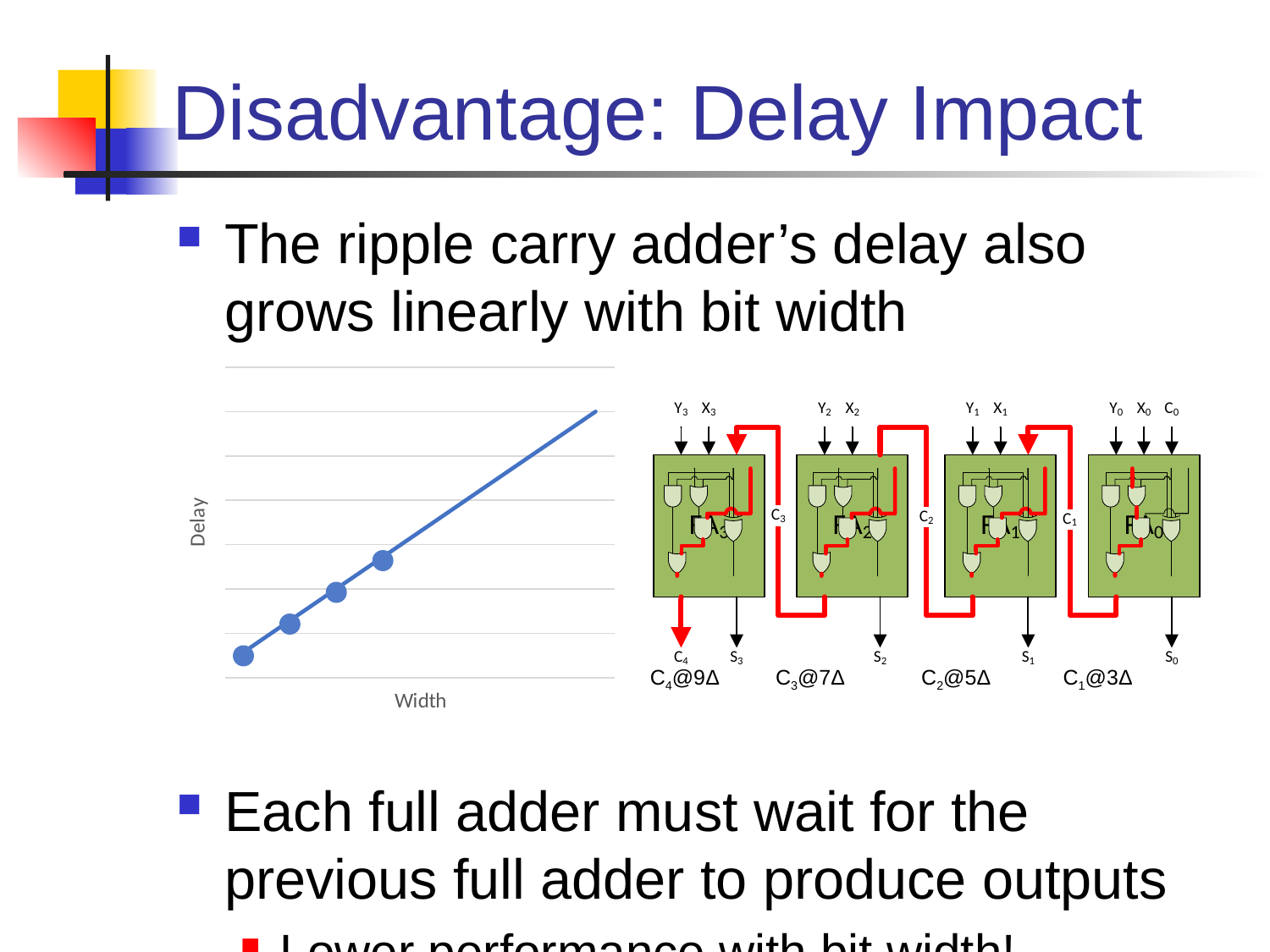
What is the label of the horizontal axis of the chart? Width What is the label of the vertical axis of the chart? Delay Do the plotted values rise or fall as Width increases along the x axis? rise Which plotted point has the highest Delay, the leftmost or the rightmost? rightmost Which plotted point has the lowest Delay, the leftmost or the rightmost? leftmost What kind of chart is shown on the slide? line chart Is the Delay of the second point from the left larger or smaller than that of the third point from the left? smaller